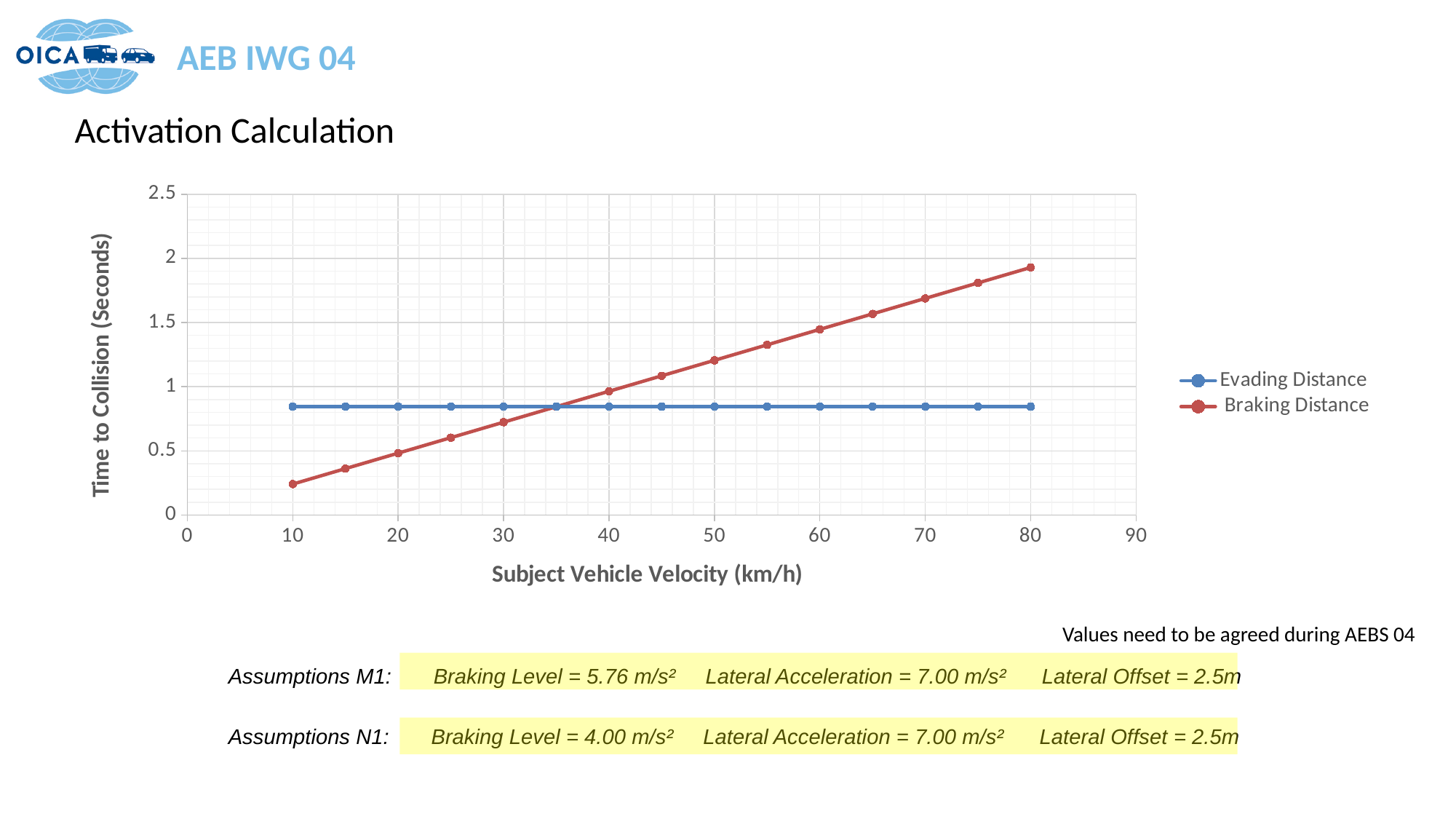
How many series does the legend list? 2 At which velocity is the Braking Distance value highest? 80 How many data points are plotted for the Braking Distance series? 15 At 80 km/h, which series has the larger value, Evading Distance or Braking Distance? Braking Distance What kind of chart is shown on the slide? line chart Is the Braking Distance value at 80 km/h greater or less than 1.5? greater At which velocity is the Braking Distance value lowest? 10 What is the title of the x axis? Subject Vehicle Velocity (km/h) At 10 km/h, which series has the larger value, Evading Distance or Braking Distance? Evading Distance Is the Evading Distance value at 40 km/h greater or less than 1? less What are the two series named in the legend? Evading Distance and Braking Distance Does the Braking Distance series rise or fall as velocity increases? rise